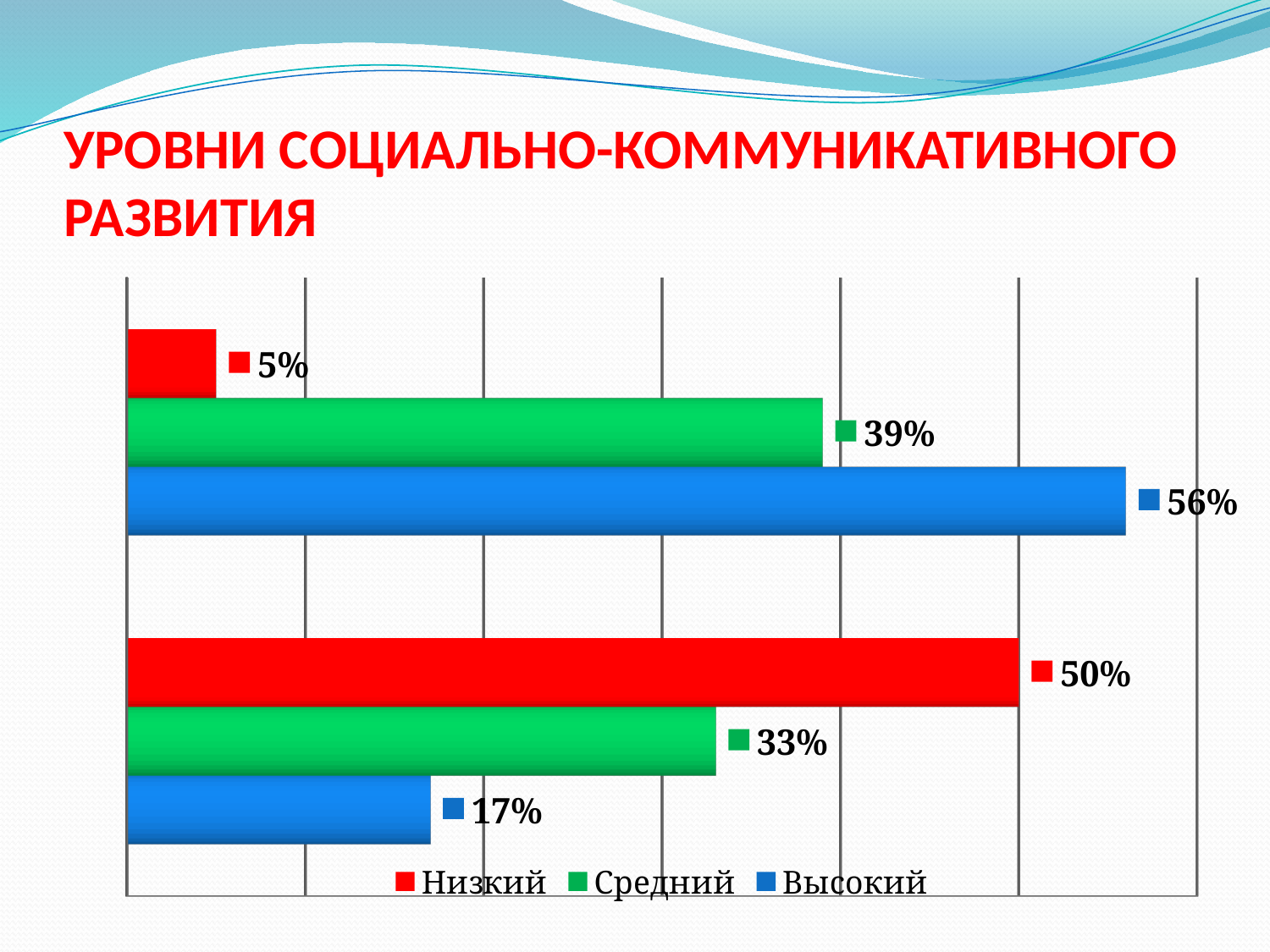
How many series does the legend list? 3 What is the value of the Низкий bar in the bottom group of bars? 50% Which is larger: the Средний value in the top group or the Средний value in the bottom group? top group (39%) What is the difference between the Высокий values in the top group and the bottom group? 39% What is the value of the Средний bar in the bottom group of bars? 33% Which series has the highest value in the top group of bars? Высокий What kind of chart is shown on the slide? bar chart Which colour represents the Средний series in the chart? green What is the value of the Низкий bar in the top group of bars? 5% Which series has the lowest value in the bottom group of bars? Высокий What is the value of the Высокий bar in the top group of bars? 56% How many groups of bars are shown in the chart? 2